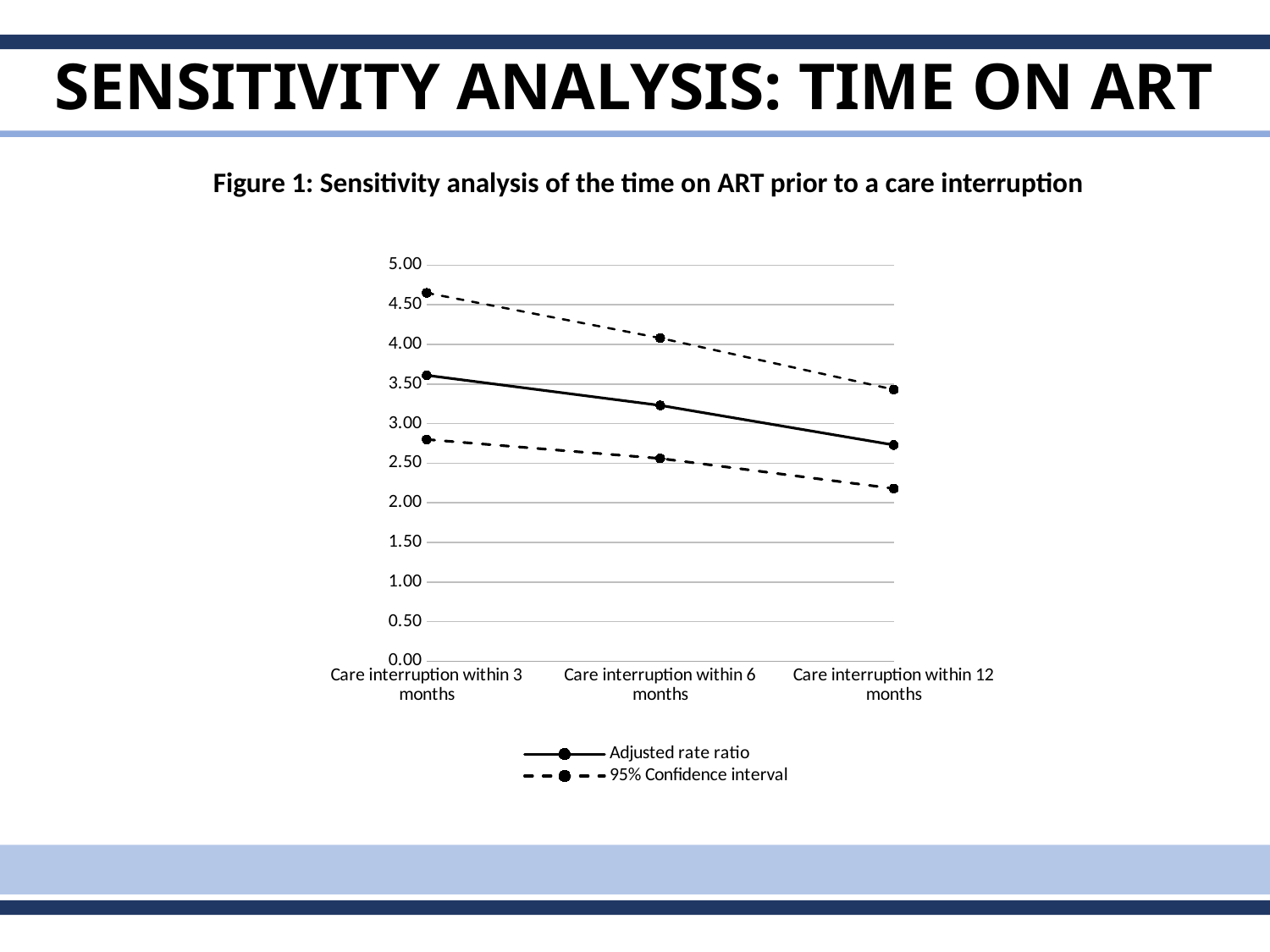
How many categories are shown on the x axis of the chart? 3 What kind of chart is shown on the slide? Line chart Is the adjusted rate ratio for care interruption within 6 months greater or less than 3.00? greater Is the adjusted rate ratio for care interruption within 12 months greater or less than 3.00? less Is the lower 95% confidence interval bound for care interruption within 12 months greater or less than 2.00? greater How many series does the chart's legend list? 2 For which category is the adjusted rate ratio highest? Care interruption within 3 months Which is larger: the adjusted rate ratio for care interruption within 3 months or for care interruption within 6 months? Care interruption within 3 months What is the title of the figure shown on the slide? Figure 1: Sensitivity analysis of the time on ART prior to a care interruption Does the adjusted rate ratio rise or fall as the care interruption window increases from 3 to 12 months? Fall For which category is the adjusted rate ratio lowest? Care interruption within 12 months